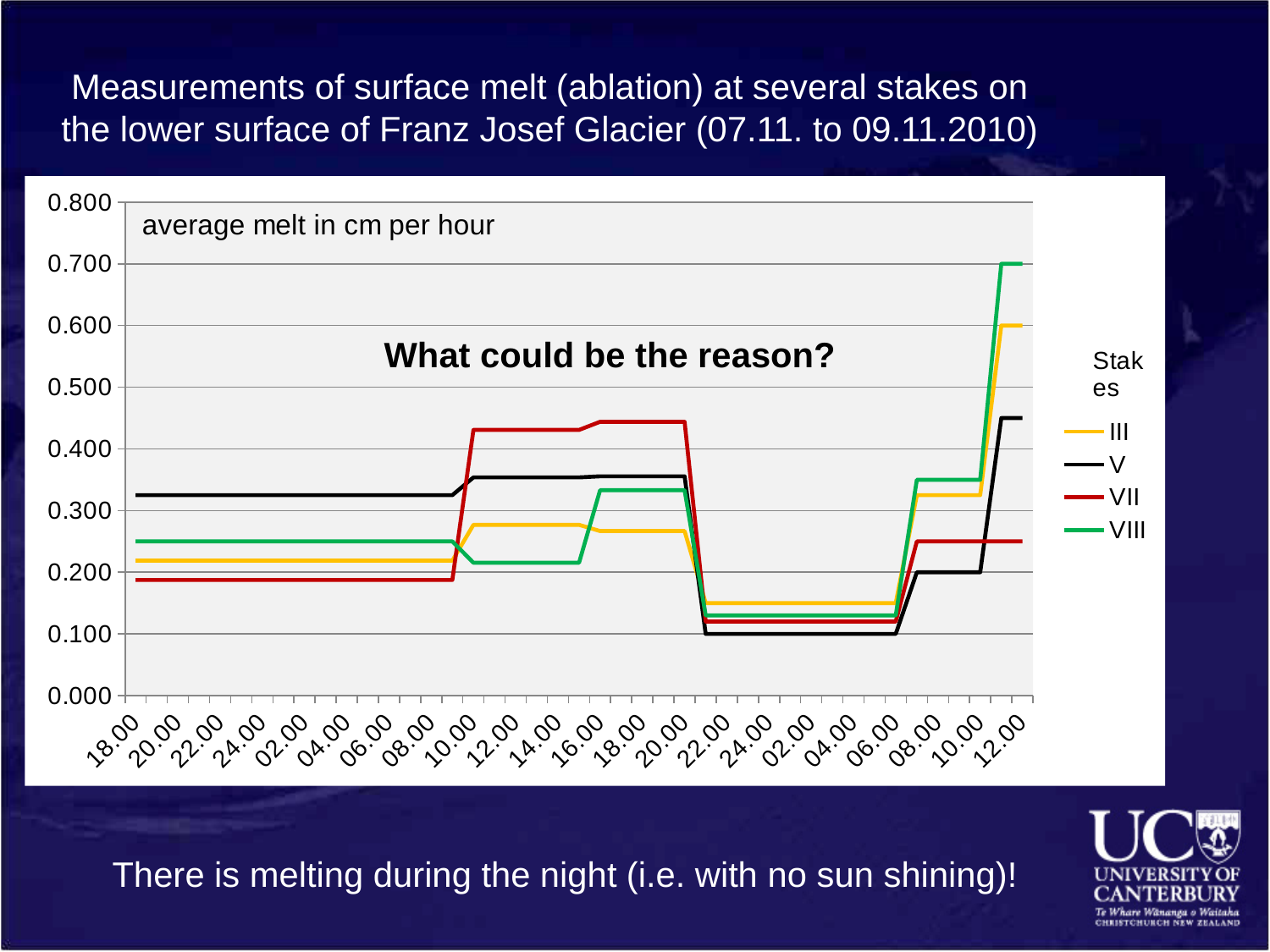
What value does stake III reach at the final 12.00 time point? 0.600 Which stake has the highest melt rate at the final 12.00 time point? VIII What unit label is written inside the chart area? average melt in cm per hour What kind of chart is shown on the slide? line chart Is the value for stake VII at 12.00 on the first day greater or less than 0.400? greater Do the melt rates rise or fall between 06.00 and 12.00 on the last day? rise Is the value for stake VIII at the first 18.00 time point greater or less than 0.300? less At the first 18.00 time point, which stake has the larger melt rate, V or VII? V Which stake has the lowest melt rate during the second night (22.00 to 06.00)? V What is the melt rate for stake V during the second night (22.00 to 06.00)? 0.100 What value does stake VIII reach at the final 12.00 time point? 0.700 How many stakes (series) does the legend list? 4